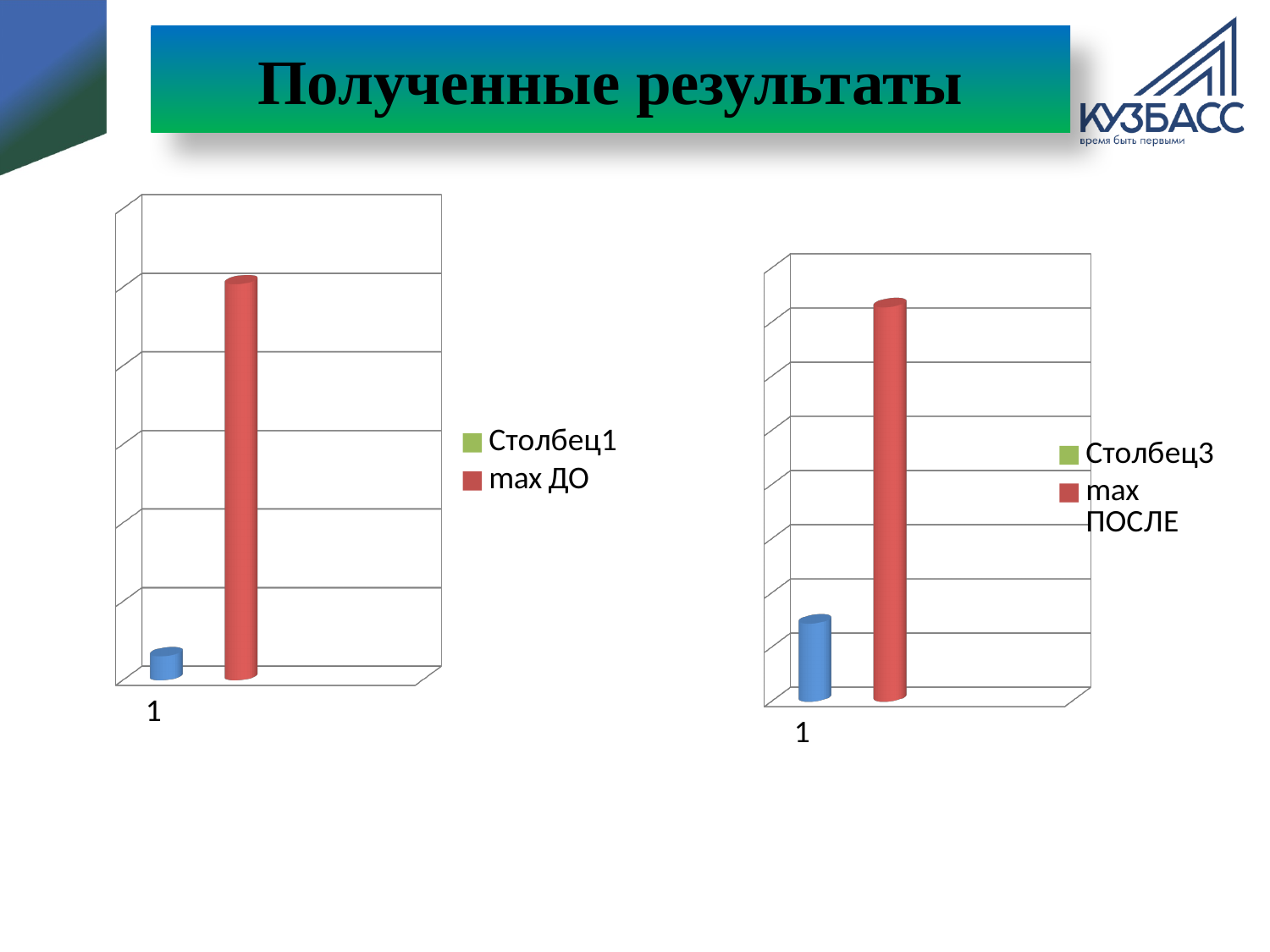
In the right chart, how many series does the legend list? 2 In the right chart, which series has the taller bar, Столбец3 or max ПОСЛЕ? max ПОСЛЕ In the left chart, which series has the taller bar, Столбец1 or max ДО? max ДО In the left chart, how many series does the legend list? 2 What are the legend entries of the left chart? Столбец1, max ДО What kind of chart is the right chart on the slide? bar chart In the right chart, which series has the highest bar? max ПОСЛЕ In the right chart, how many categories are shown on the x axis? 1 In the left chart, how many categories are shown on the x axis? 1 What kind of chart is the left chart on the slide? bar chart What are the legend entries of the right chart? Столбец3, max ПОСЛЕ